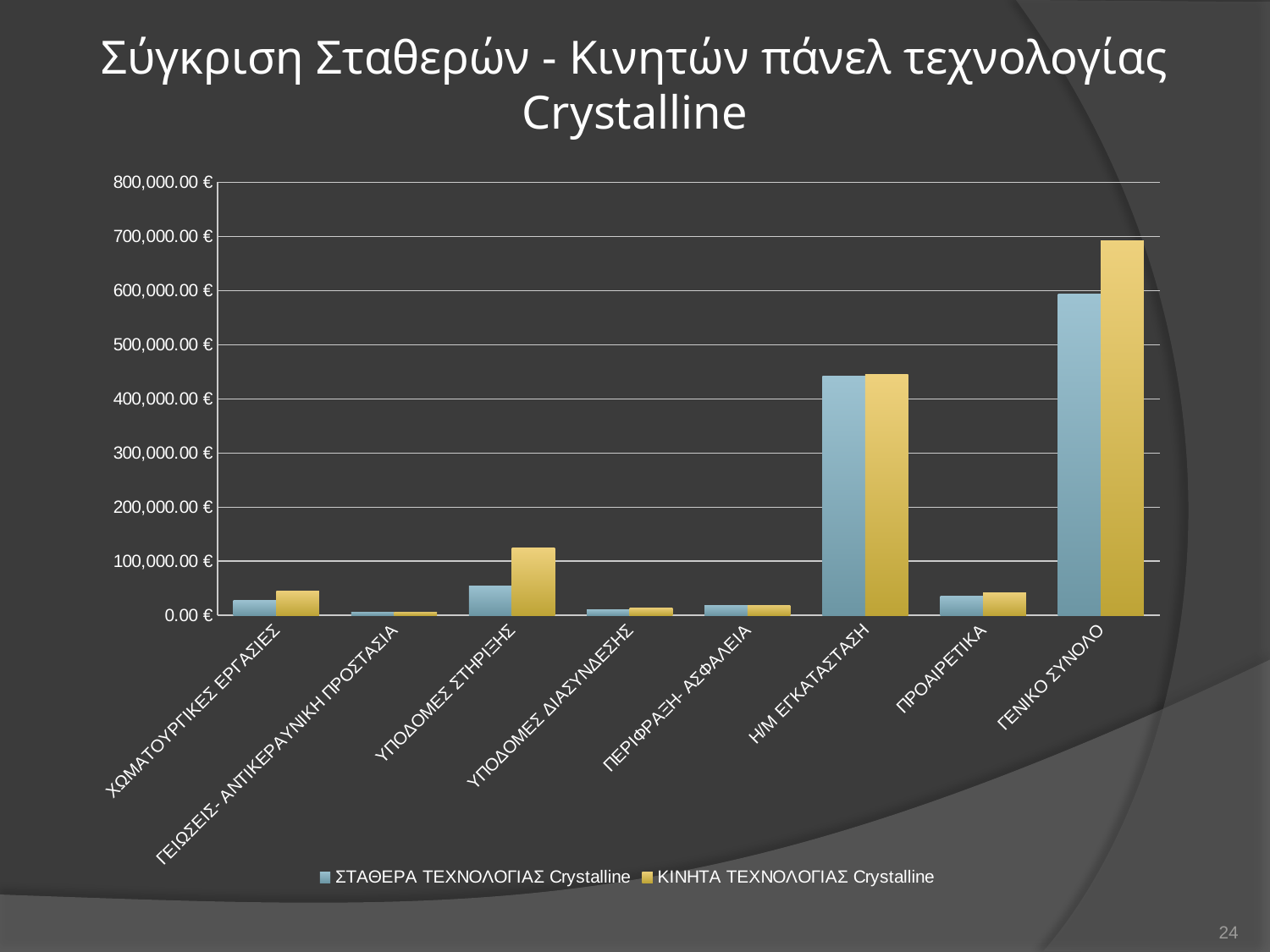
Is the ΚΙΝΗΤΑ ΤΕΧΝΟΛΟΓΙΑΣ Crystalline value for ΥΠΟΔΟΜΕΣ ΣΤΗΡΙΞΗΣ greater or less than 100,000.00 €? greater Is the ΣΤΑΘΕΡΑ ΤΕΧΝΟΛΟΓΙΑΣ Crystalline value for Η/Μ ΕΓΚΑΤΑΣΤΑΣΗ greater or less than 400,000.00 €? greater Which category has the lowest value for the ΣΤΑΘΕΡΑ ΤΕΧΝΟΛΟΓΙΑΣ Crystalline series? ΓΕΙΩΣΕΙΣ - ΑΝΤΙΚΕΡΑΥΝΙΚΗ ΠΡΟΣΤΑΣΙΑ Which category has the highest value for the ΚΙΝΗΤΑ ΤΕΧΝΟΛΟΓΙΑΣ Crystalline series? ΓΕΝΙΚΟ ΣΥΝΟΛΟ How many categories are shown on the x axis? 8 What kind of chart is shown on the slide? Bar chart For ΓΕΝΙΚΟ ΣΥΝΟΛΟ, which series has the larger value, ΣΤΑΘΕΡΑ ΤΕΧΝΟΛΟΓΙΑΣ Crystalline or ΚΙΝΗΤΑ ΤΕΧΝΟΛΟΓΙΑΣ Crystalline? ΚΙΝΗΤΑ ΤΕΧΝΟΛΟΓΙΑΣ Crystalline For ΥΠΟΔΟΜΕΣ ΣΤΗΡΙΞΗΣ, which series has the larger value, ΣΤΑΘΕΡΑ ΤΕΧΝΟΛΟΓΙΑΣ Crystalline or ΚΙΝΗΤΑ ΤΕΧΝΟΛΟΓΙΑΣ Crystalline? ΚΙΝΗΤΑ ΤΕΧΝΟΛΟΓΙΑΣ Crystalline Is the ΣΤΑΘΕΡΑ ΤΕΧΝΟΛΟΓΙΑΣ Crystalline value for ΓΕΝΙΚΟ ΣΥΝΟΛΟ greater or less than 500,000.00 €? greater How many series does the legend list? 2 What is the title of the chart on the slide? Σύγκριση Σταθερών - Κινητών πάνελ τεχνολογίας Crystalline